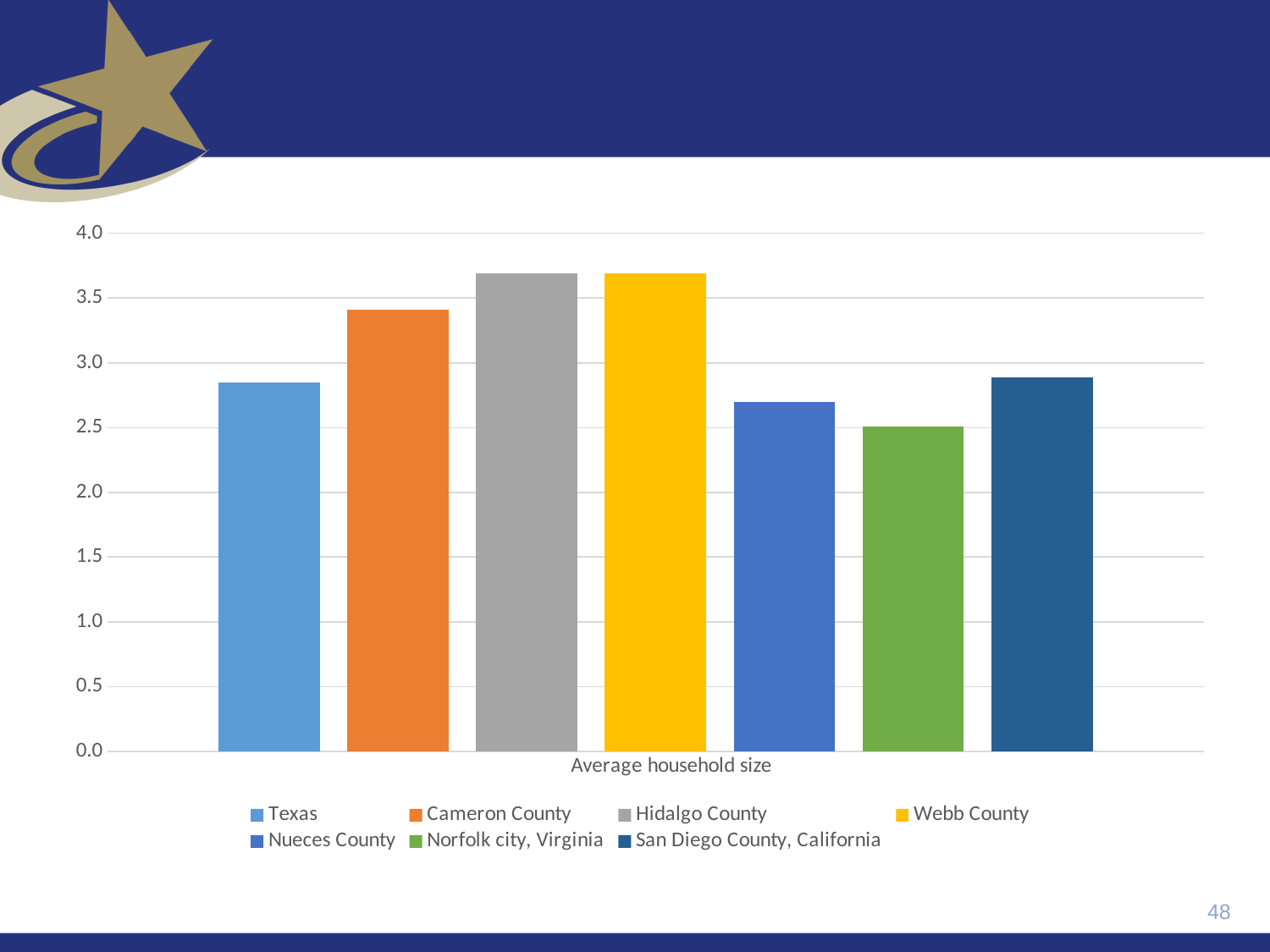
What is the label shown on the x axis of the chart? Average household size Is the value for Hidalgo County greater or less than 3.5? greater Is the value for San Diego County, California greater or less than 3.0? less Is the value for Nueces County greater or less than 3.0? less Which is larger, the value for Nueces County or the value for Norfolk city, Virginia? Nueces County How many series does the legend list? 7 What kind of chart is shown on the slide? bar chart Which series has the lowest average household size? Norfolk city, Virginia Which is larger, the value for Cameron County or the value for Texas? Cameron County